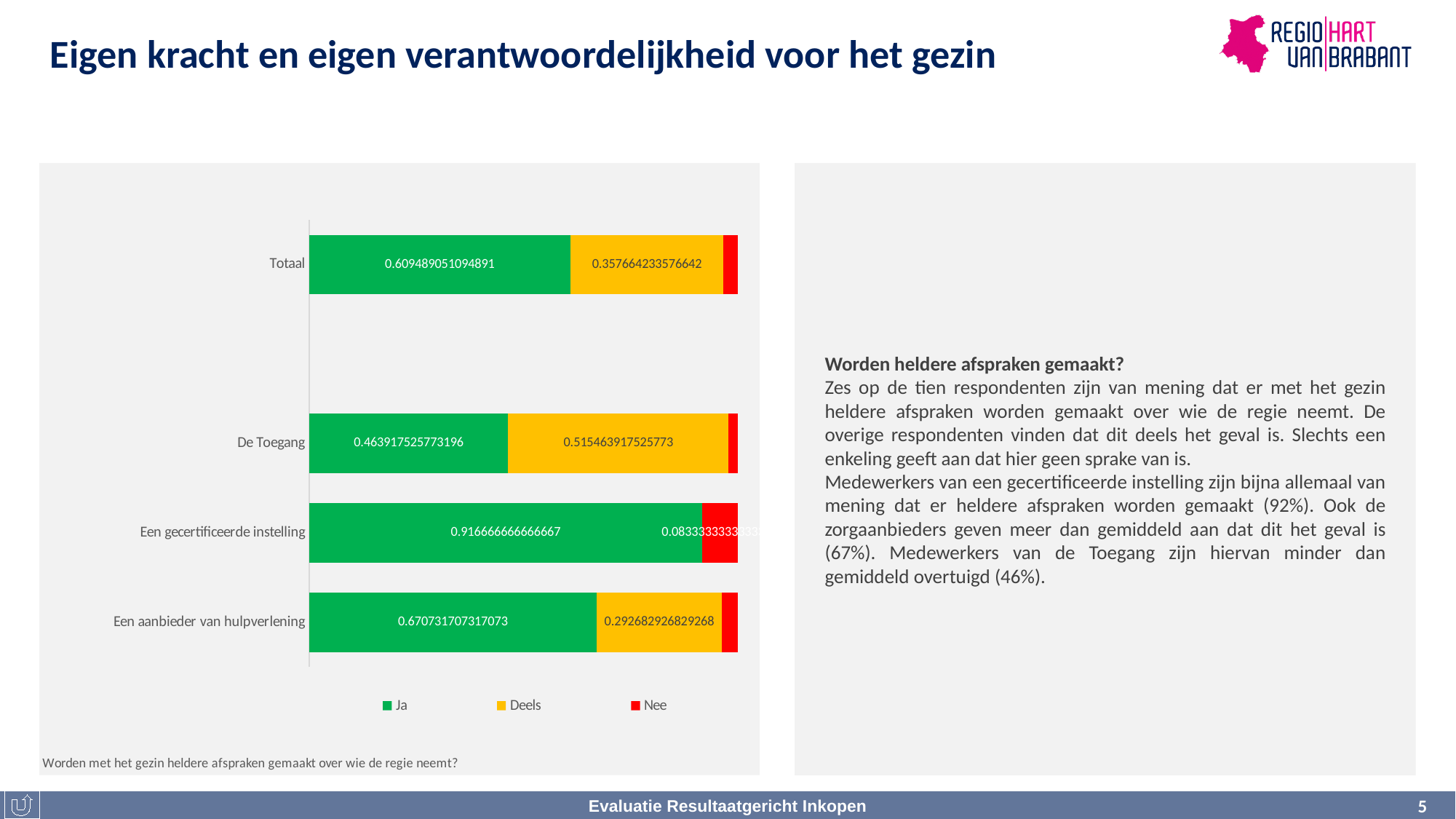
Which category has the highest value for the Ja series? Een gecertificeerde instelling What is the value of the Deels series for Een aanbieder van hulpverlening? 0.292682926829268 Which series is shown in red in the legend? Nee What kind of chart is shown on the slide? Stacked bar chart What is the value of the Ja series for Totaal? 0.609489051094891 Which is larger for De Toegang: the Ja value or the Deels value? Deels Which category has the lowest value for the Ja series? De Toegang What is the value of the Ja series for De Toegang? 0.463917525773196 How many series does the legend list? 3 How many categories are shown on the chart? 4 What is the value of the Ja series for Een gecertificeerde instelling? 0.916666666666667 What is the value of the Deels series for De Toegang? 0.515463917525773